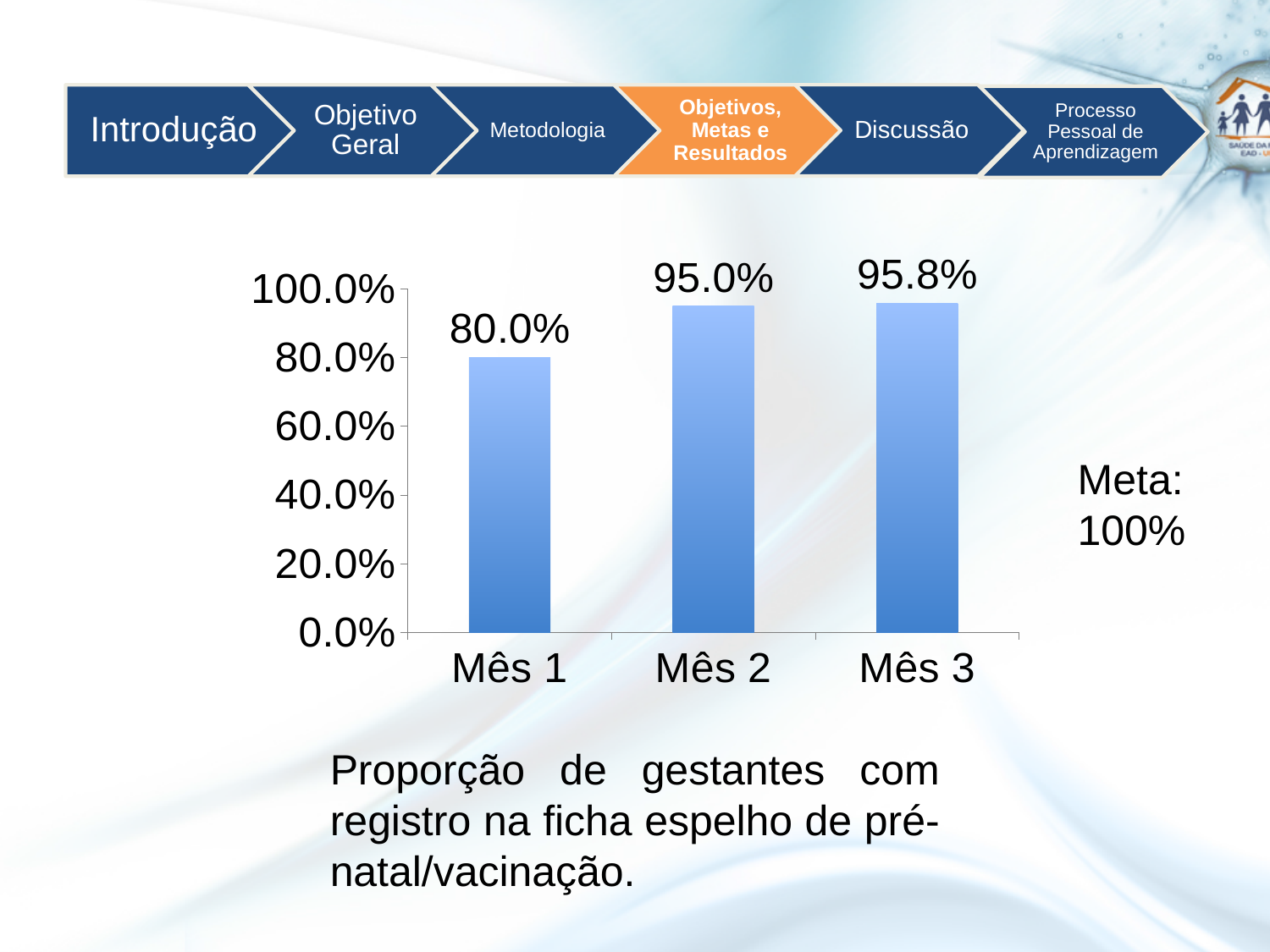
Which is larger, the value for Mês 1 or the value for Mês 2? Mês 2 What is the value for Mês 3? 95.8% Is the value for Mês 1 greater or less than 60.0%? greater Do the values rise or fall from Mês 1 to Mês 3? Rise Which month has the highest value? Mês 3 What is the value for Mês 2? 95.0% What kind of chart is shown on the slide? Bar chart What is the difference between the values for Mês 3 and Mês 2? 0.8% What is the difference between the values for Mês 2 and Mês 1? 15.0% What is the value for Mês 1? 80.0% Which month has the lowest value? Mês 1 How many months are shown on the x axis? 3